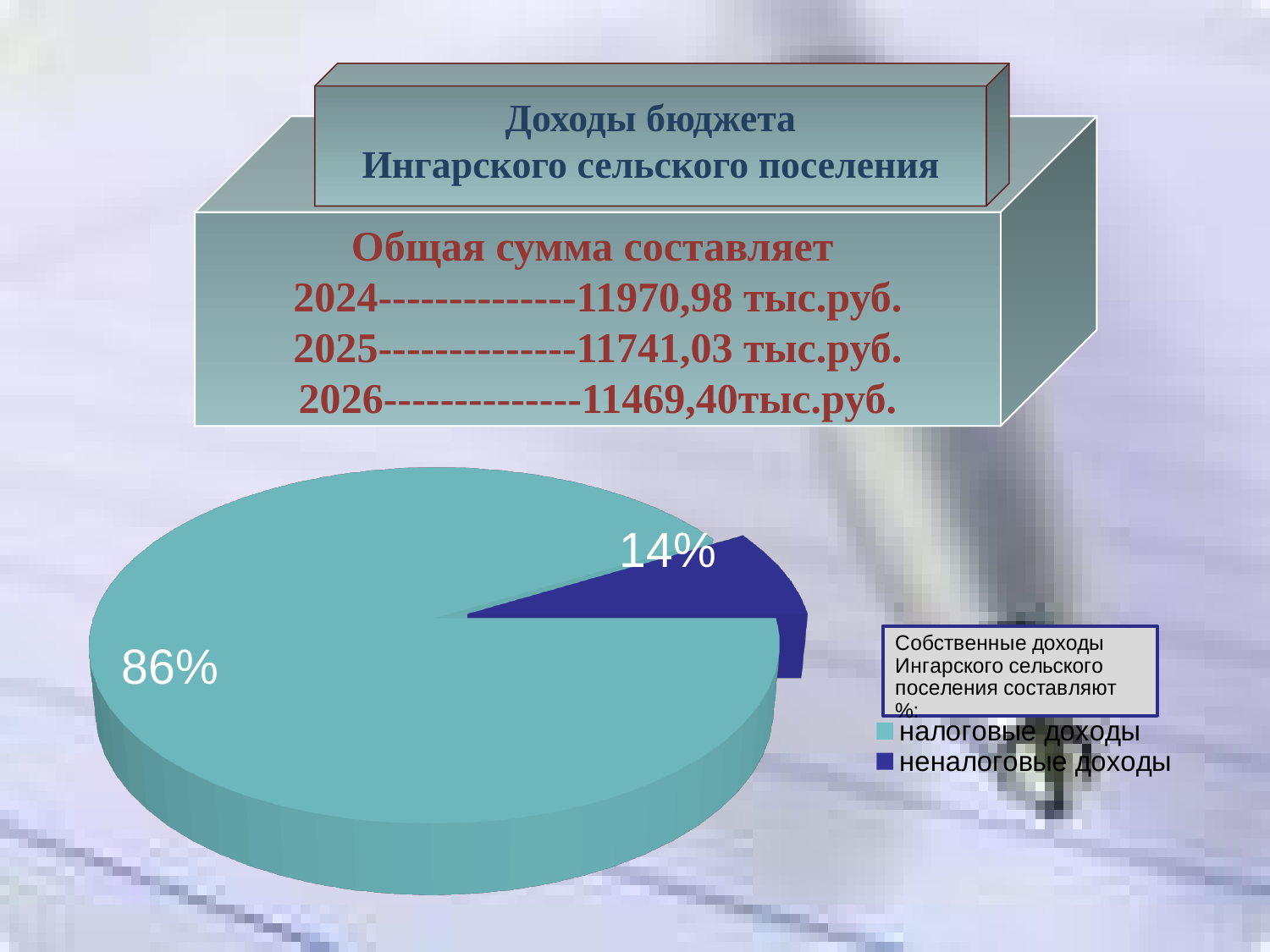
What colour is the "неналоговые доходы" slice? dark blue Which is larger: the "налоговые доходы" slice or the "неналоговые доходы" slice? налоговые доходы What is the difference in percentage points between the "налоговые доходы" and "неналоговые доходы" slices? 72 Which slice of the pie is the largest? налоговые доходы Which legend entry is shown in light teal? налоговые доходы What kind of chart is shown on the slide? pie chart How many entries does the chart legend list? 2 How many slices does the pie chart have? 2 What is the total of the two pie slice percentages shown? 100% What share of the pie does "налоговые доходы" take? 86% What share of the pie does "неналоговые доходы" take? 14% Which slice of the pie is the smallest? неналоговые доходы